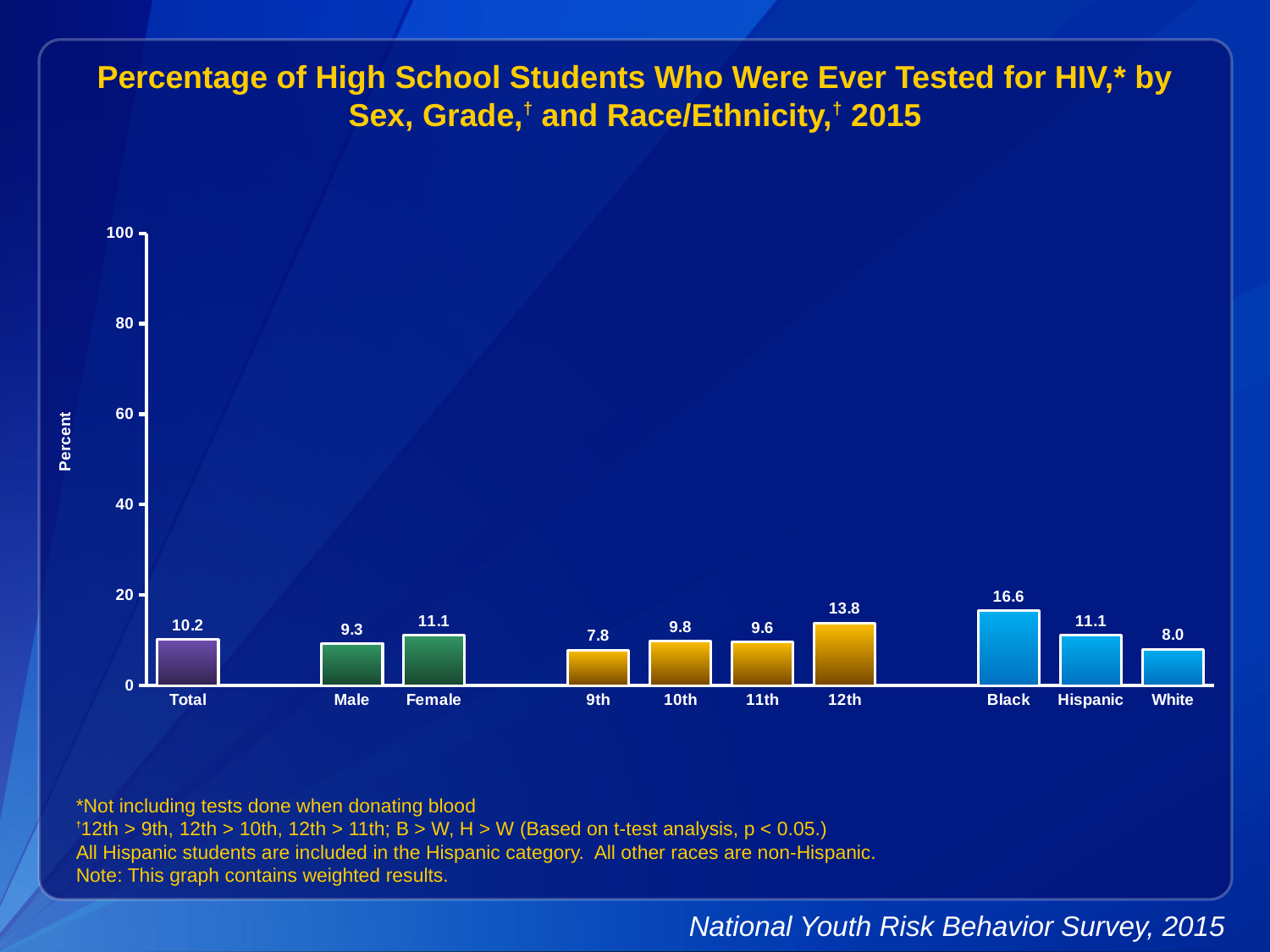
What is the difference between the values for Black and White? 8.6 Is the value for Black greater or less than 20? less What is the value for Female? 11.1 What is the value for 12th grade? 13.8 What is the difference between the values for Female and Male? 1.8 What kind of chart is shown on the slide? bar chart Which is larger, the value for 12th grade or the value for 9th grade? 12th Which category has the lowest value? 9th Which category has the highest value? Black What is the value for White? 8.0 How many categories are shown on the x axis? 10 What is the value for Total? 10.2